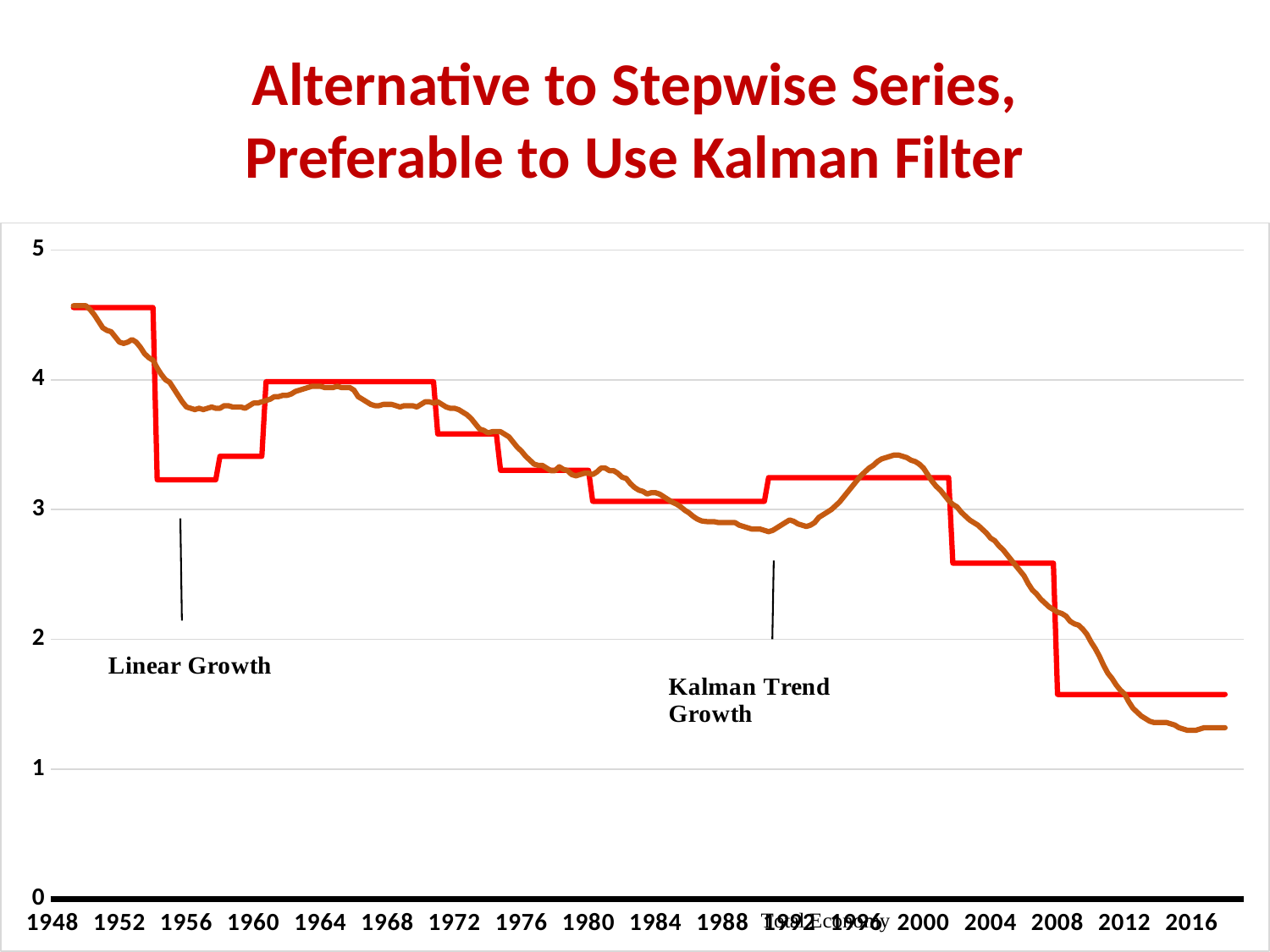
Is the Linear Growth value in 1956 greater or less than 3? greater What are the names of the two series labelled on the chart? Linear Growth and Kalman Trend Growth Is the Kalman Trend Growth value in 2016 greater or less than 2? less What kind of chart is shown on the slide? line chart In 1956, which series has the higher value, Linear Growth or Kalman Trend Growth? Kalman Trend Growth Is the Kalman Trend Growth value in 1948 greater or less than 4? greater Overall, do the values rise or fall from 1948 to 2016? fall In 1992, which series has the higher value, Linear Growth or Kalman Trend Growth? Linear Growth How many series are plotted on the chart? 2 What is the first year shown on the x axis? 1948